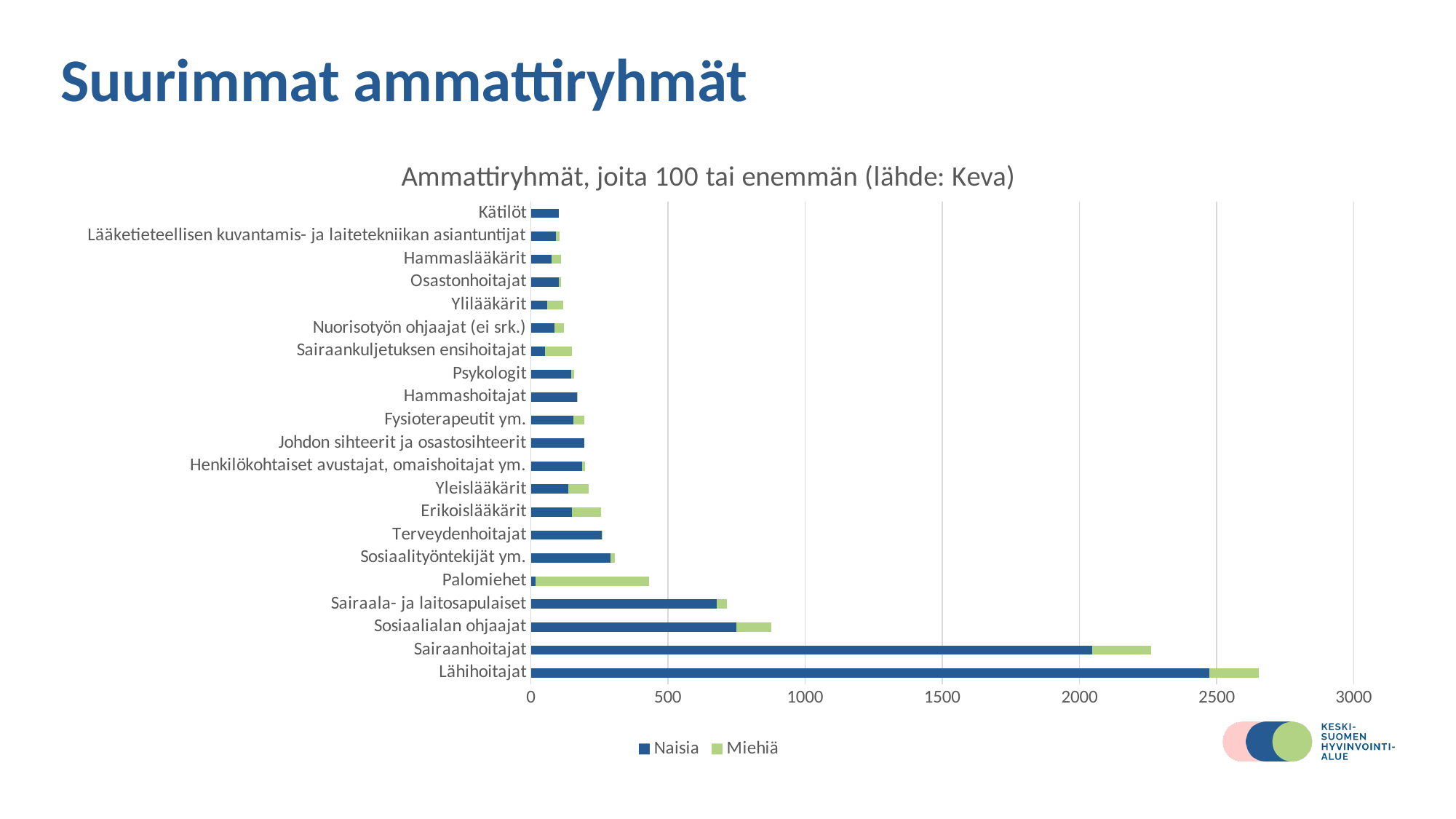
Is the total bar for Sairaala- ja laitosapulaiset greater or less than 500? greater How many occupational groups (categories) are shown in the chart? 21 What kind of chart is shown on the slide? bar chart Is the total bar for Sosiaalialan ohjaajat greater or less than 1000? less Which series is shown in green in the chart? Miehiä Which has the larger total bar, Sairaanhoitajat or Sosiaalialan ohjaajat? Sairaanhoitajat How many series does the legend list? 2 Is the total bar for Lähihoitajat greater or less than 2500? greater Which occupational group has the longest bar in the chart? Lähihoitajat What is the title of the chart? Ammattiryhmät, joita 100 tai enemmän (lähde: Keva) For Palomiehet, which series makes up the larger part of the bar, Naisia or Miehiä? Miehiä